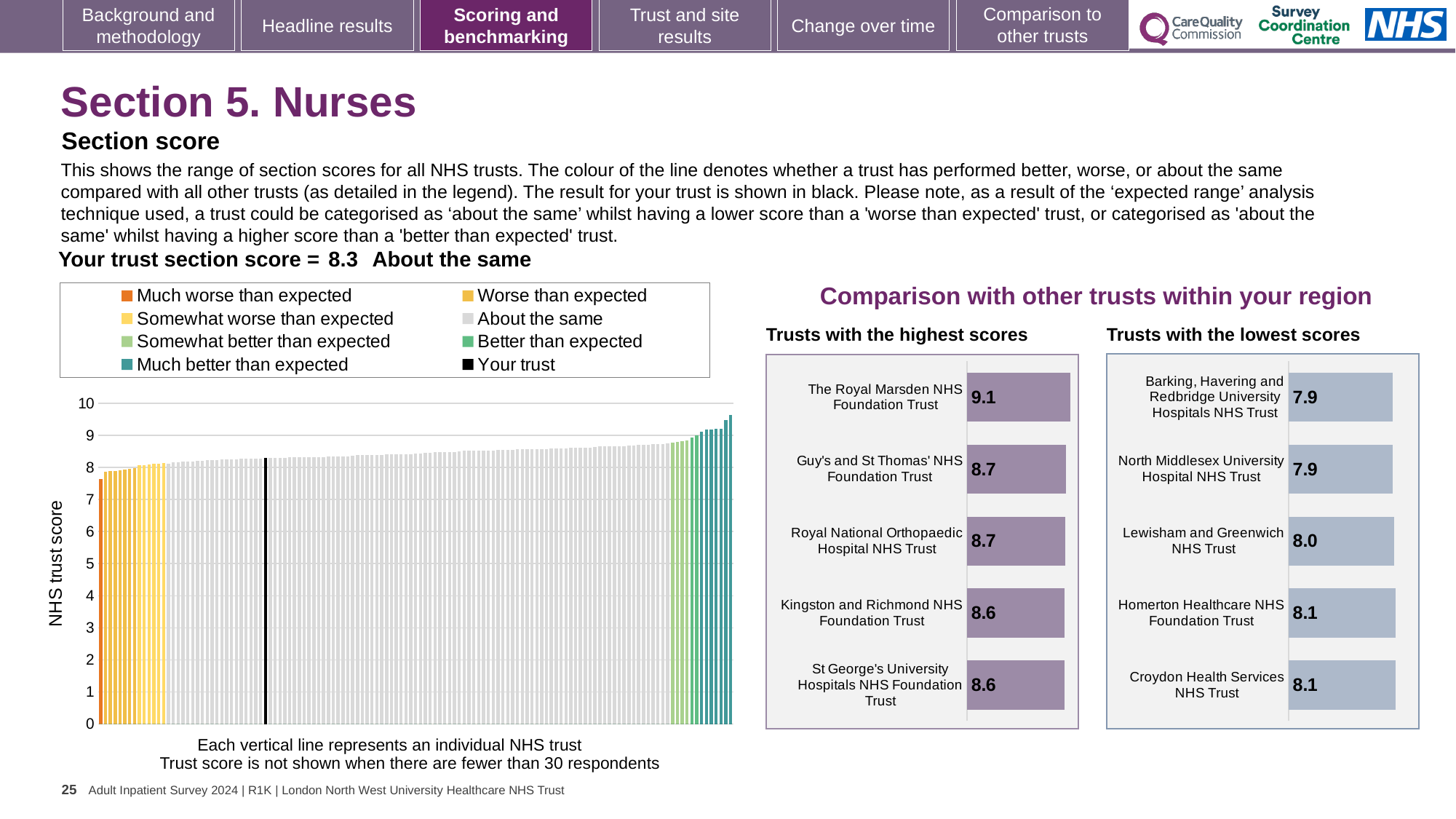
In the 'Trusts with the highest scores' chart, what is the difference between the scores of The Royal Marsden NHS Foundation Trust and Kingston and Richmond NHS Foundation Trust? 0.5 In the 'NHS trust score' chart on the left, is the value of the tallest bar greater or less than 9? greater In the 'Trusts with the highest scores' chart, which trust has the highest score? The Royal Marsden NHS Foundation Trust In the 'Trusts with the lowest scores' chart, what is the score for Lewisham and Greenwich NHS Trust? 8.0 In the 'Trusts with the lowest scores' chart, which has the larger score: Homerton Healthcare NHS Foundation Trust or Barking, Havering and Redbridge University Hospitals NHS Trust? Homerton Healthcare NHS Foundation Trust How many entries does the legend of the 'NHS trust score' chart on the left list? 8 In the 'Trusts with the lowest scores' chart, what is the score for Croydon Health Services NHS Trust? 8.1 What kind of chart is the large 'NHS trust score' chart on the left of the slide? bar chart What is the difference between the score of The Royal Marsden NHS Foundation Trust in the 'highest scores' chart and Barking, Havering and Redbridge University Hospitals NHS Trust in the 'lowest scores' chart? 1.2 In the 'Trusts with the highest scores' chart, how many trusts are listed? 5 In the 'Trusts with the highest scores' chart, what is the score for The Royal Marsden NHS Foundation Trust? 9.1 In the 'NHS trust score' chart on the left, what is the section score for your trust (the black bar)? 8.3